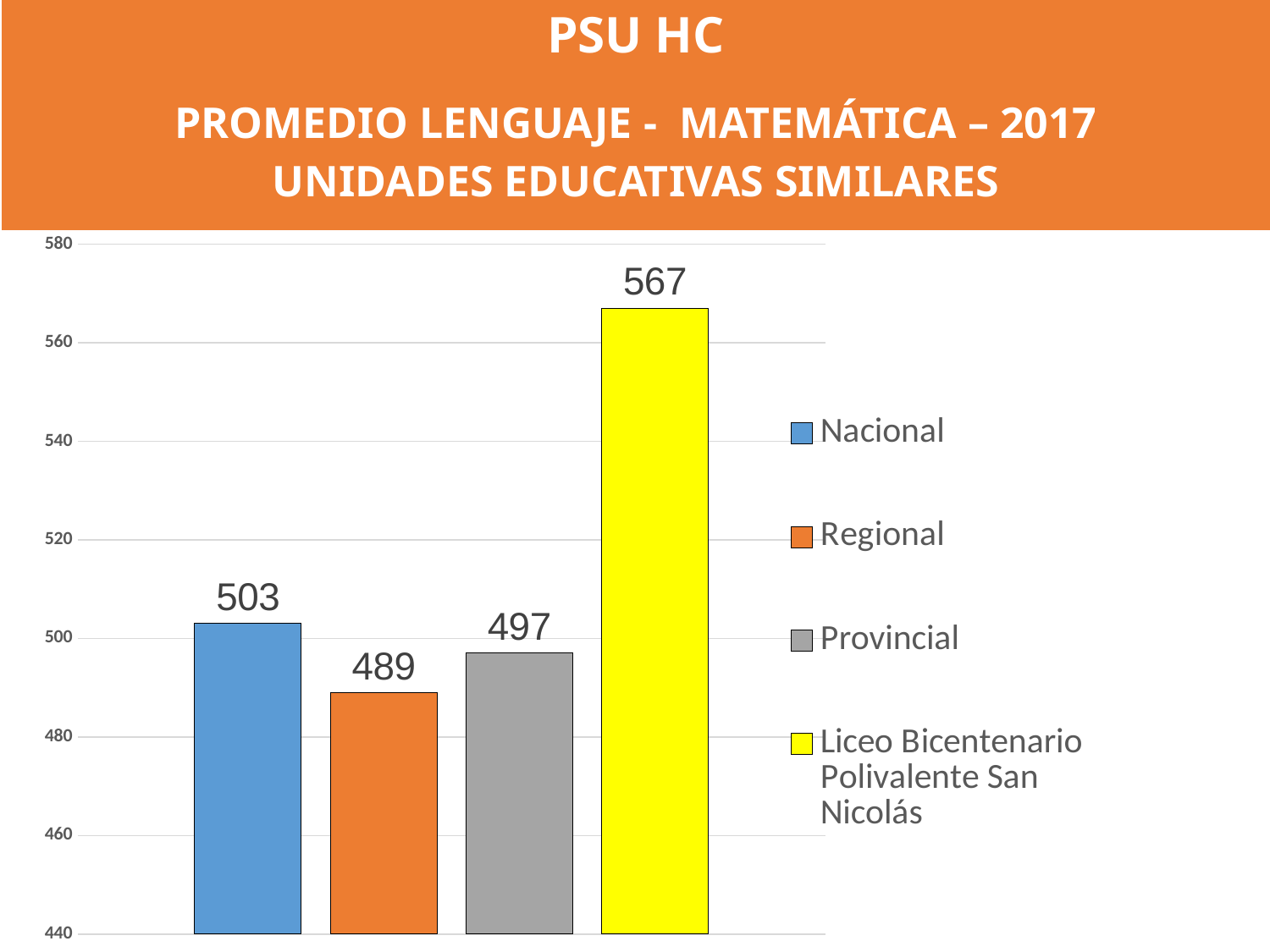
Which is larger, the value for Nacional or the value for Provincial? Nacional What is the value for Provincial? 497 Which series has the highest value? Liceo Bicentenario Polivalente San Nicolás How many series does the legend list? 4 What is the difference between the values for Liceo Bicentenario Polivalente San Nicolás and Nacional? 64 What is the value for Nacional? 503 What is the value for Regional? 489 What is the difference between the values for Nacional and Regional? 14 What kind of chart is shown on the slide? Bar chart What colour is the bar for Liceo Bicentenario Polivalente San Nicolás? Yellow What is the value for Liceo Bicentenario Polivalente San Nicolás? 567 Which series has the lowest value? Regional